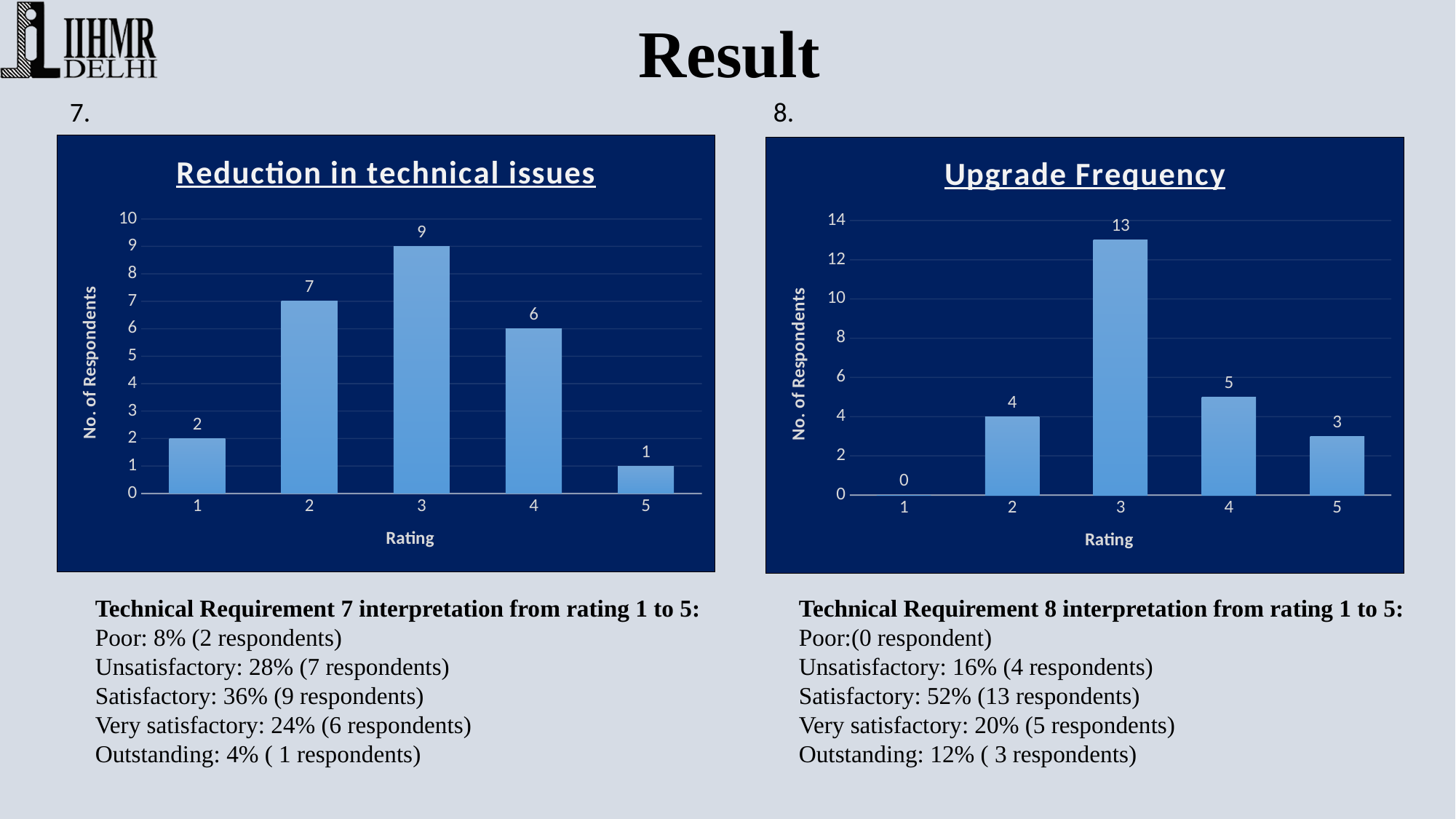
In the 'Upgrade Frequency' chart, is the value for rating 3 greater or less than 12? greater In the 'Reduction in technical issues' chart, how many respondents gave a rating of 3? 9 In the 'Upgrade Frequency' chart, how many respondents gave a rating of 3? 13 What type of chart is the 'Upgrade Frequency' chart? Bar chart In the 'Reduction in technical issues' chart, what is the difference in respondents between rating 2 and rating 4? 1 In the 'Reduction in technical issues' chart, which rating has the lowest number of respondents? 5 In the 'Upgrade Frequency' chart, which rating has the lowest number of respondents? 1 In the 'Upgrade Frequency' chart, what is the difference in respondents between rating 3 and rating 4? 8 In the 'Reduction in technical issues' chart, which rating has more respondents, 2 or 4? 2 What is the y-axis label of the 'Reduction in technical issues' chart? No. of Respondents In the 'Upgrade Frequency' chart, which rating has the highest number of respondents? 3 How many rating categories are shown on the x axis of the 'Reduction in technical issues' chart? 5